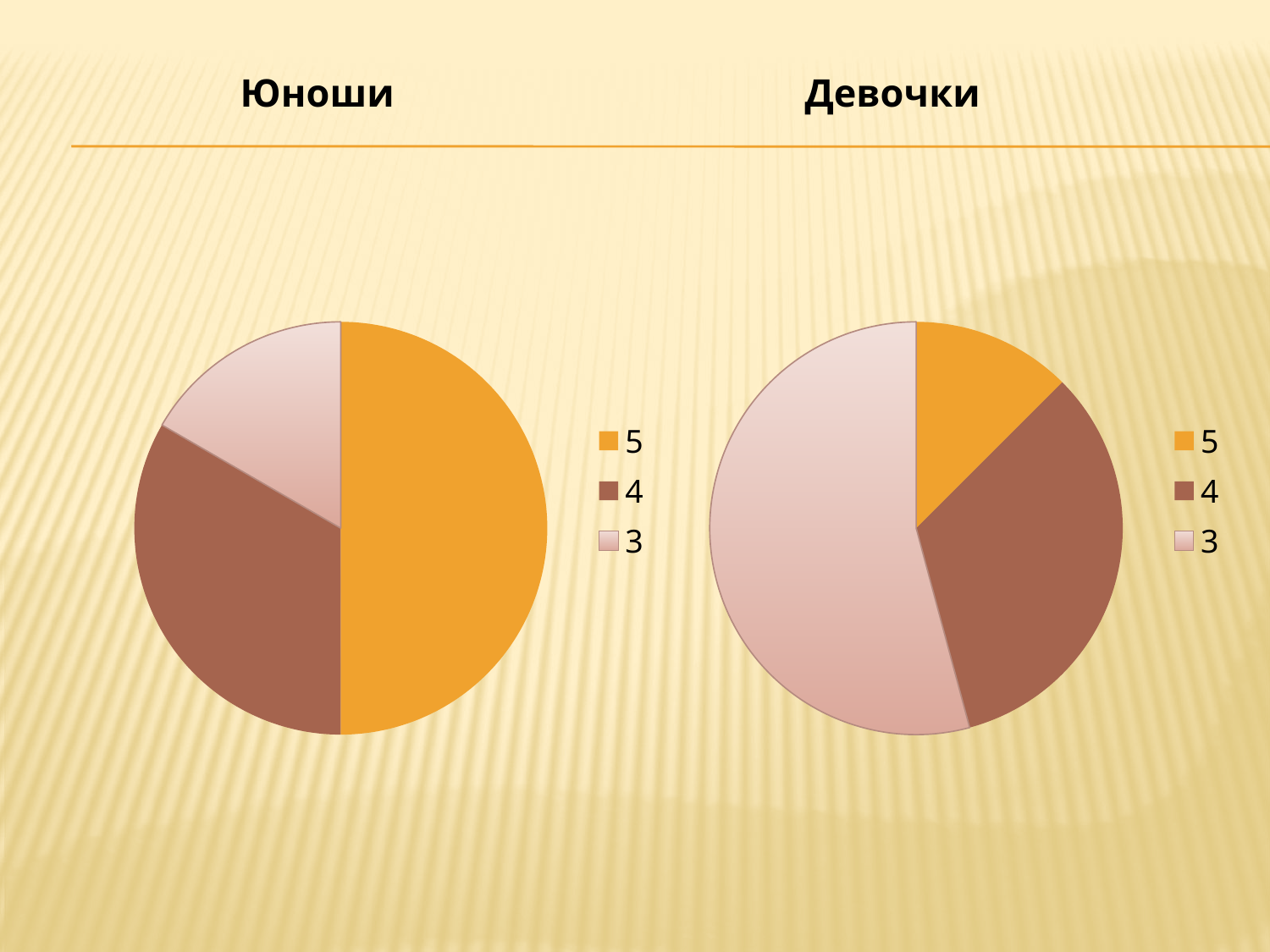
In the chart titled "Юноши", which category has the smallest slice? 3 In the chart titled "Девочки", which slice is larger, 5 or 4? 4 In the chart titled "Девочки", which category has the smallest slice? 5 What are the titles of the two charts on the slide, from left to right? Юноши, Девочки In the chart titled "Юноши", which category has the largest slice? 5 In the chart titled "Девочки", how many entries does the legend list? 3 What kind of chart is the chart titled "Юноши"? pie chart In the chart titled "Девочки", what colour is the slice for category 5? orange What kind of chart is the chart titled "Девочки"? pie chart In the chart titled "Юноши", which slice is larger, 4 or 3? 4 In the chart titled "Девочки", which category has the largest slice? 3 In the chart titled "Юноши", how many slices does the pie have? 3